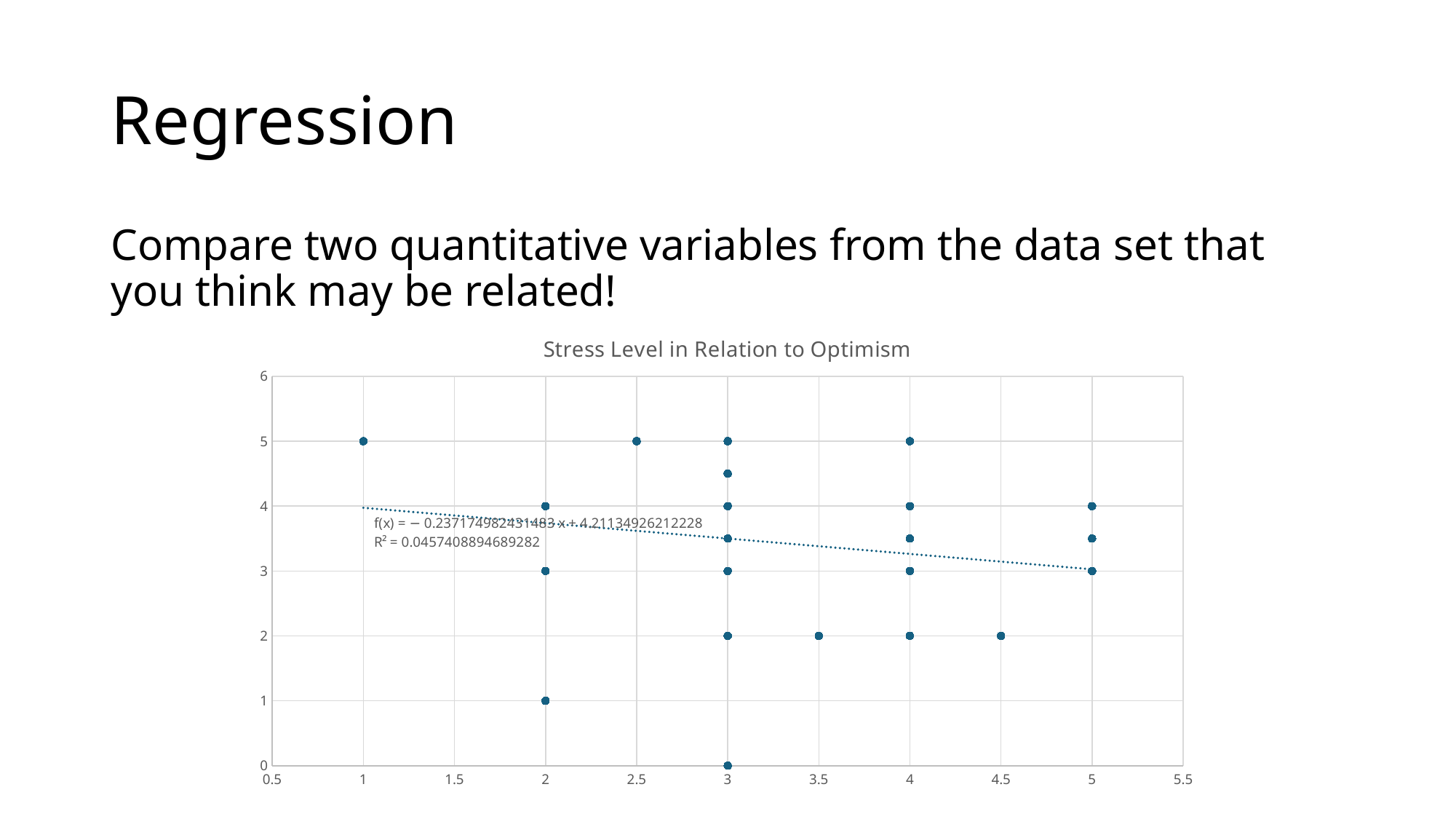
What is the y value of the point plotted at x = 3.5? 2 Does the dotted trendline rise or fall as x increases? Falls What kind of chart is shown on the slide? Scatter plot What is the y value of the single point plotted at x = 1? 5 What is the title of the chart? Stress Level in Relation to Optimism What R² value is printed on the chart? R² = 0.0457408894689282 What is the highest y value reached by any plotted point? 5 What is the lowest y value of any plotted point? 0 Is the y value of the point at x = 4.5 greater or less than 3? less What is the intercept of the fitted line f(x) shown on the chart? 4.21134926212228 What is the slope of the fitted line f(x) shown on the chart? −0.237174982431483